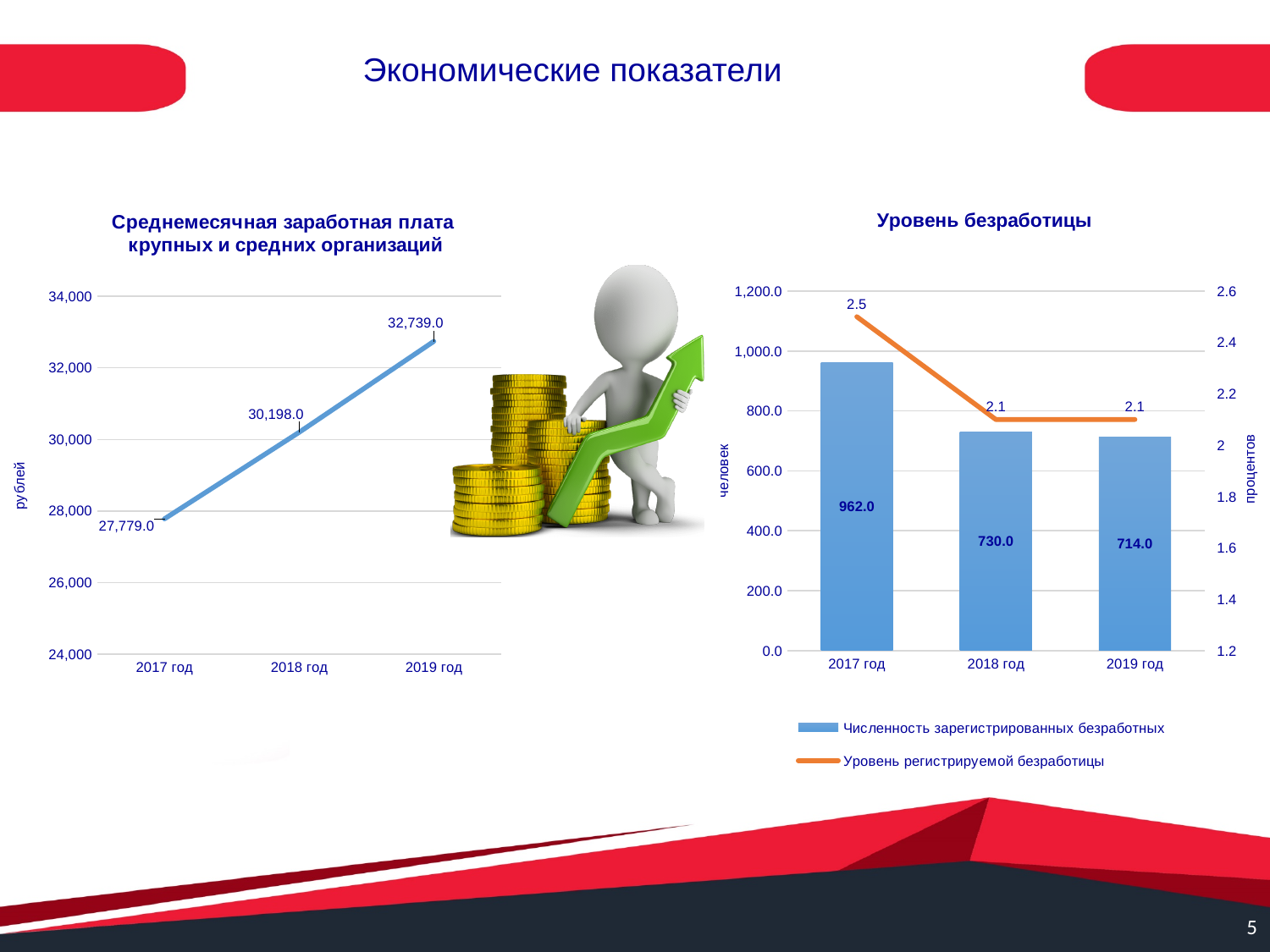
In the chart 'Среднемесячная заработная плата крупных и средних организаций', which year has the lowest value? 2017 год In the chart 'Среднемесячная заработная плата крупных и средних организаций', what is the value for 2018 год? 30,198.0 In the chart 'Уровень безработицы', what is the value of 'Численность зарегистрированных безработных' for 2017 год? 962.0 In the chart 'Уровень безработицы', what is the value of 'Уровень регистрируемой безработицы' for 2019 год? 2.1 In the chart 'Среднемесячная заработная плата крупных и средних организаций', what is the difference between the 2019 год and 2017 год values? 4,960.0 In the chart 'Уровень безработицы', what is the difference in 'Численность зарегистрированных безработных' between 2017 год and 2018 год? 232.0 In the chart 'Среднемесячная заработная плата крупных и средних организаций', what is the value for 2019 год? 32,739.0 In the chart 'Уровень безработицы', which year has the lowest value of 'Численность зарегистрированных безработных'? 2019 год What kind of chart is 'Среднемесячная заработная плата крупных и средних организаций'? line chart In the chart 'Среднемесячная заработная плата крупных и средних организаций', do the values rise or fall from 2017 год to 2019 год? rise In the chart 'Уровень безработицы', is the value of 'Численность зарегистрированных безработных' for 2018 год greater or less than 800.0? less How many series does the legend of the chart 'Уровень безработицы' list? 2